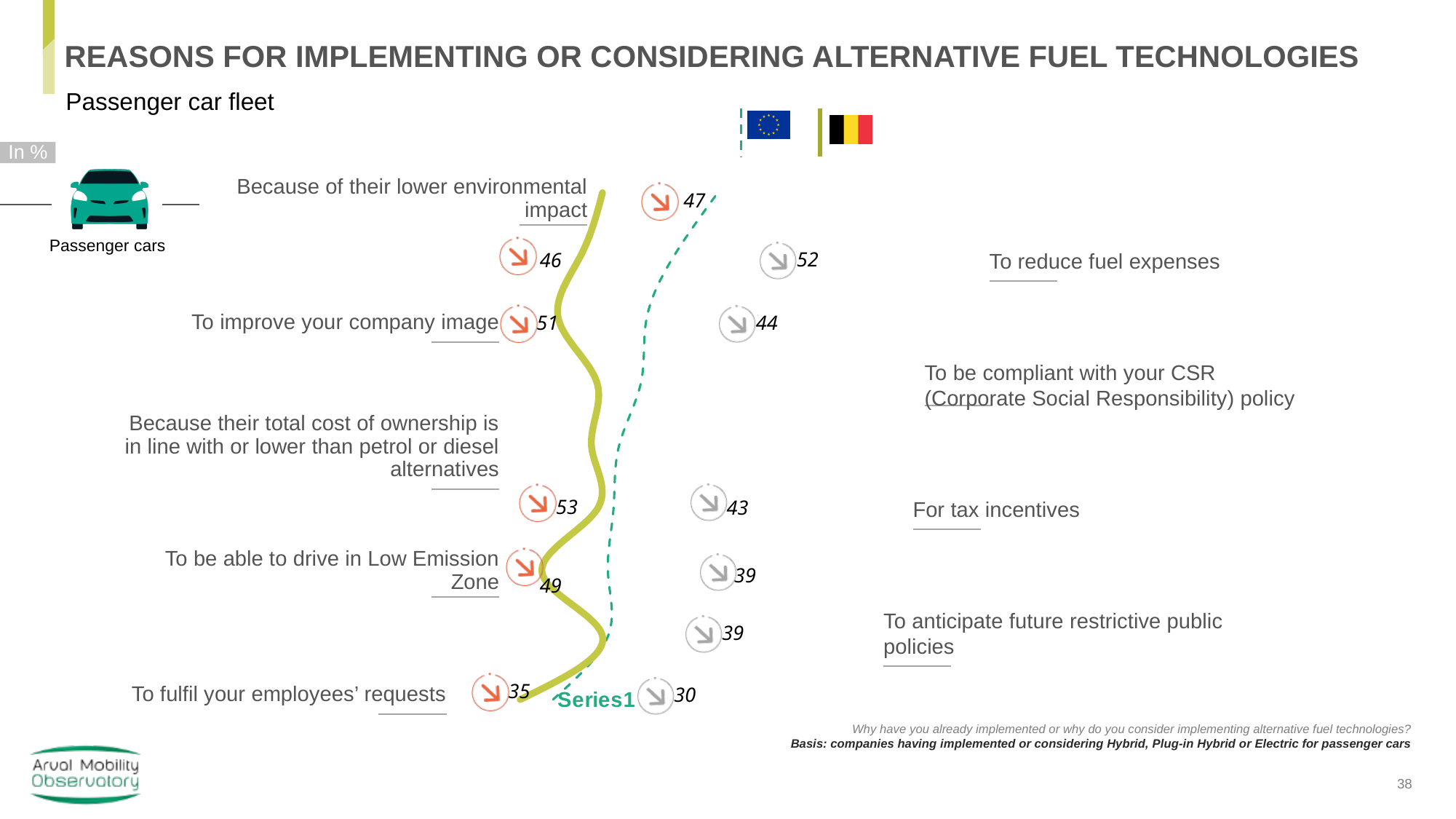
What is the difference between the orange-marker value (35) and the grey-marker value (30) in the 'To fulfil your employees' requests' row? 5 What orange-marker value is printed in the row for 'To fulfil your employees' requests'? 35 What kind of chart is shown on the slide? line chart In the 'For tax incentives' row, which is larger: the orange-marker value or the grey-marker value? the orange-marker value (53) What is the highest value printed with an orange marker on the chart? 53 How many reasons (categories) are labelled around the chart? 9 In what unit are the chart values expressed, according to the label at the top left? In % What is the difference between the orange-marker value (53) and the grey-marker value (43) in the 'For tax incentives' row? 10 What is the only entry shown in the chart's legend? Series1 What grey-marker value is printed in the row for 'To reduce fuel expenses'? 52 What is the lowest value printed with a grey marker on the chart? 30 What grey-marker value is printed in the row for 'To fulfil your employees' requests'? 30